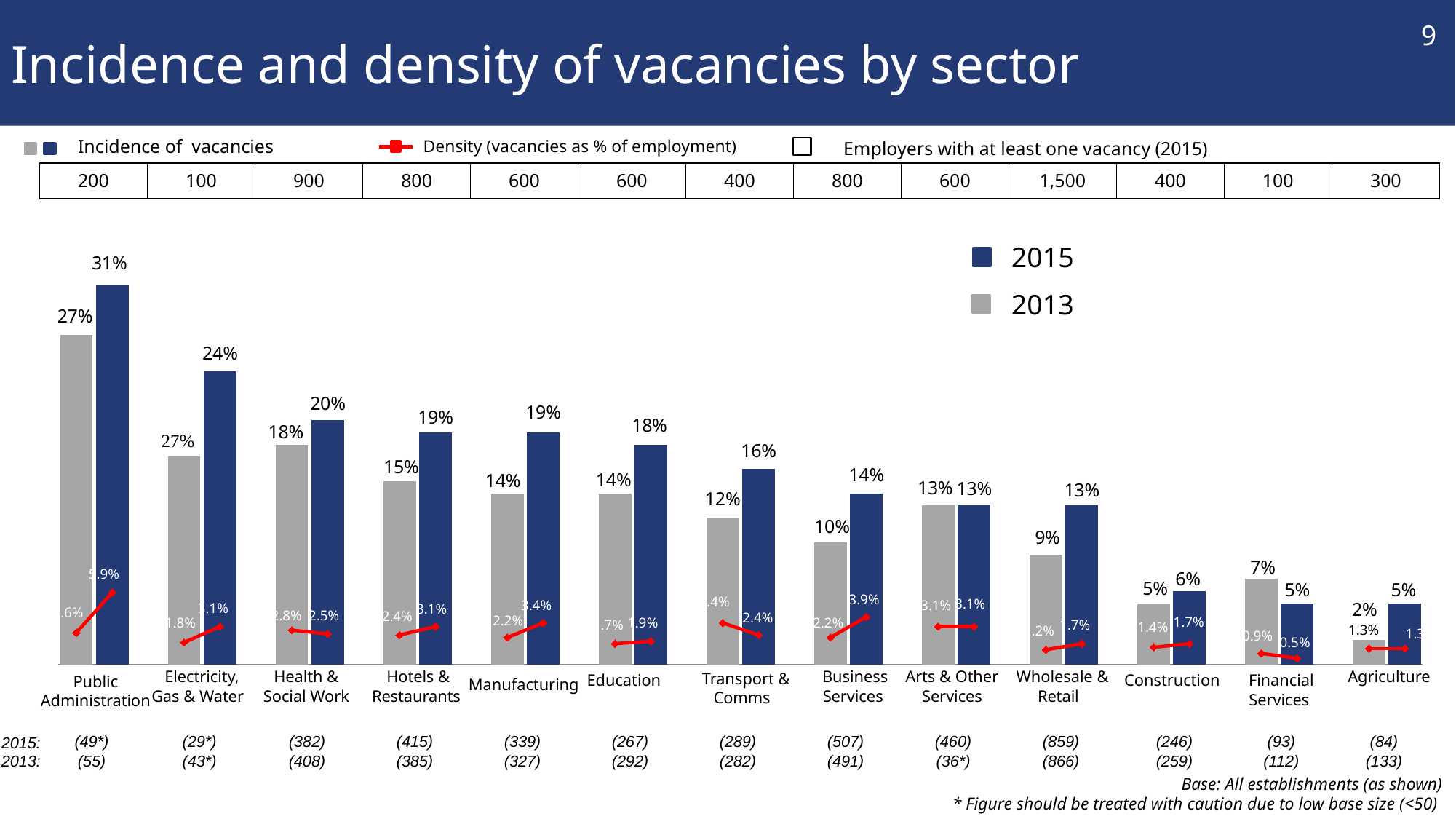
How many years does the legend in the top right of the chart list? 2 What kind of chart is used to show the incidence of vacancies by sector? bar chart According to the row of boxes, how many employers in Wholesale & Retail had at least one vacancy in 2015? 1,500 What was the incidence of vacancies for Wholesale & Retail in 2013? 9% Which sector had the highest incidence of vacancies in 2015? Public Administration What was the incidence of vacancies for Financial Services in 2015? 5% How many sectors are shown on the chart? 13 By how many percentage points did the incidence of vacancies in Public Administration rise from 2013 to 2015? 4 percentage points What was the incidence of vacancies for Public Administration in 2015? 31% What was the density of vacancies (vacancies as % of employment) for Public Administration in 2015? 5.9% Which sector had the lowest incidence of vacancies in 2013? Agriculture For Electricity, Gas & Water, which year had the higher incidence of vacancies, 2013 or 2015? 2015